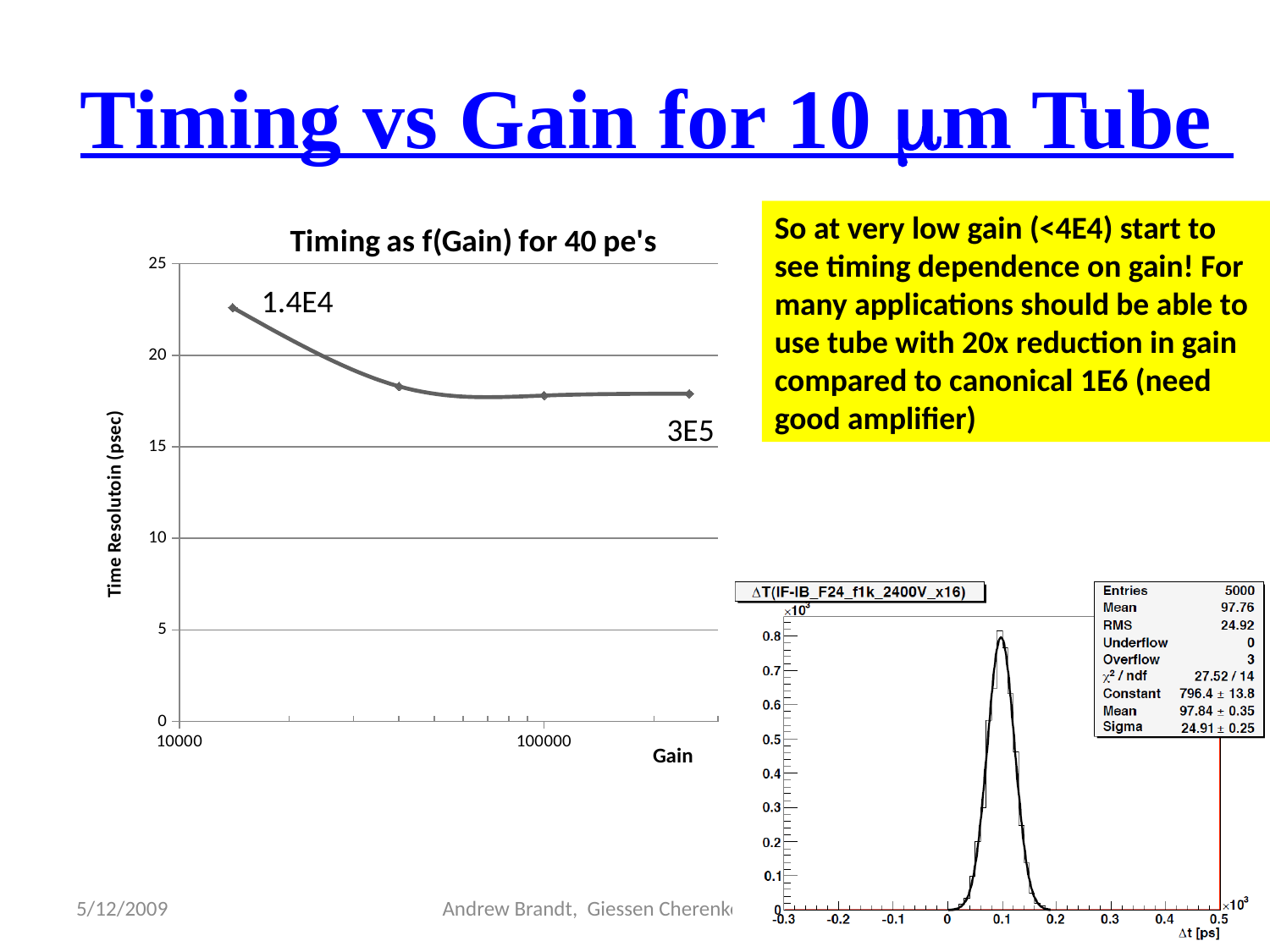
In the chart titled "Timing as f(Gain) for 40 pe's", at which labelled gain value is the time resolution highest? 1.4E4 In the chart titled "Timing as f(Gain) for 40 pe's", is the time resolution at gain 1.4E4 greater or less than 20 psec? greater In the histogram at the bottom right of the slide, what is the fitted Sigma value listed in the statistics box? 24.91 ± 0.25 In the histogram at the bottom right of the slide, what RMS value is listed in the statistics box? 24.92 In the chart titled "Timing as f(Gain) for 40 pe's", which labelled gain value, 1.4E4 or 3E5, has the higher time resolution? 1.4E4 In the chart titled "Timing as f(Gain) for 40 pe's", does the time resolution rise or fall as gain increases from 1.4E4 to 3E5? fall In the chart titled "Timing as f(Gain) for 40 pe's", how many data points are plotted on the line? 4 In the chart titled "Timing as f(Gain) for 40 pe's", what kind of chart is shown? line chart In the histogram at the bottom right of the slide, what is the Overflow value listed in the statistics box? 3 In the histogram at the bottom right of the slide, how many entries are listed in the statistics box? 5000 In the chart titled "Timing as f(Gain) for 40 pe's", is the time resolution at gain 3E5 greater or less than 20 psec? less In the chart titled "Timing as f(Gain) for 40 pe's", what is the label of the y axis? Time Resolutoin (psec)